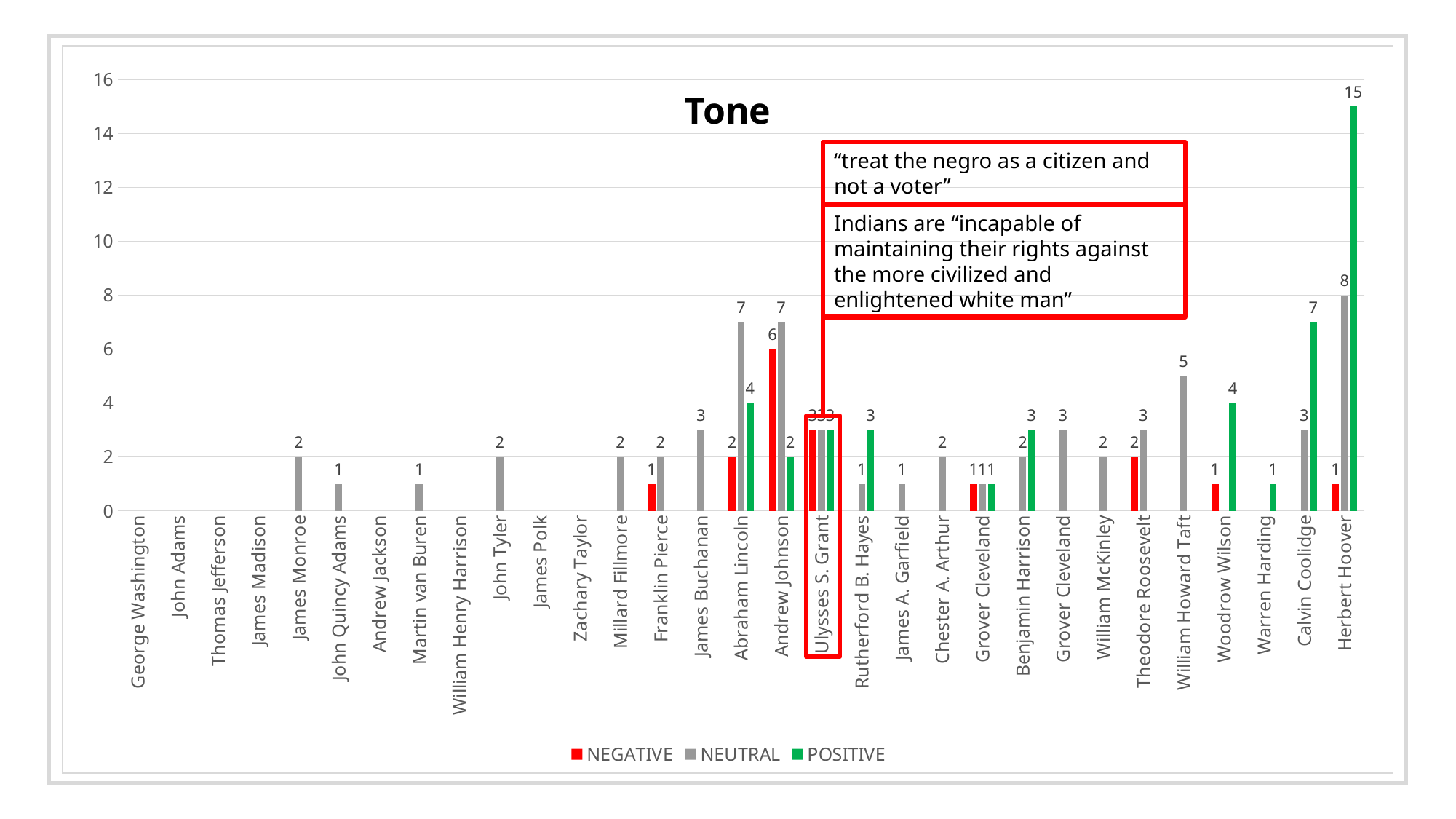
What is the NEUTRAL value for William Howard Taft? 5 Which president has the highest POSITIVE value? Herbert Hoover What is the title of the chart? Tone Which president has the highest NEGATIVE value? Andrew Johnson What kind of chart is shown on the slide? bar chart What is the difference between the NEUTRAL and POSITIVE values for Calvin Coolidge? 4 What is the total of the NEGATIVE, NEUTRAL and POSITIVE values for Ulysses S. Grant? 9 What is the NEGATIVE value for Andrew Johnson? 6 Which series is shown in green in the legend? POSITIVE What is the POSITIVE value for Herbert Hoover? 15 How many series does the legend list? 3 Which is larger, the NEUTRAL value for Abraham Lincoln or the NEUTRAL value for James Buchanan? Abraham Lincoln